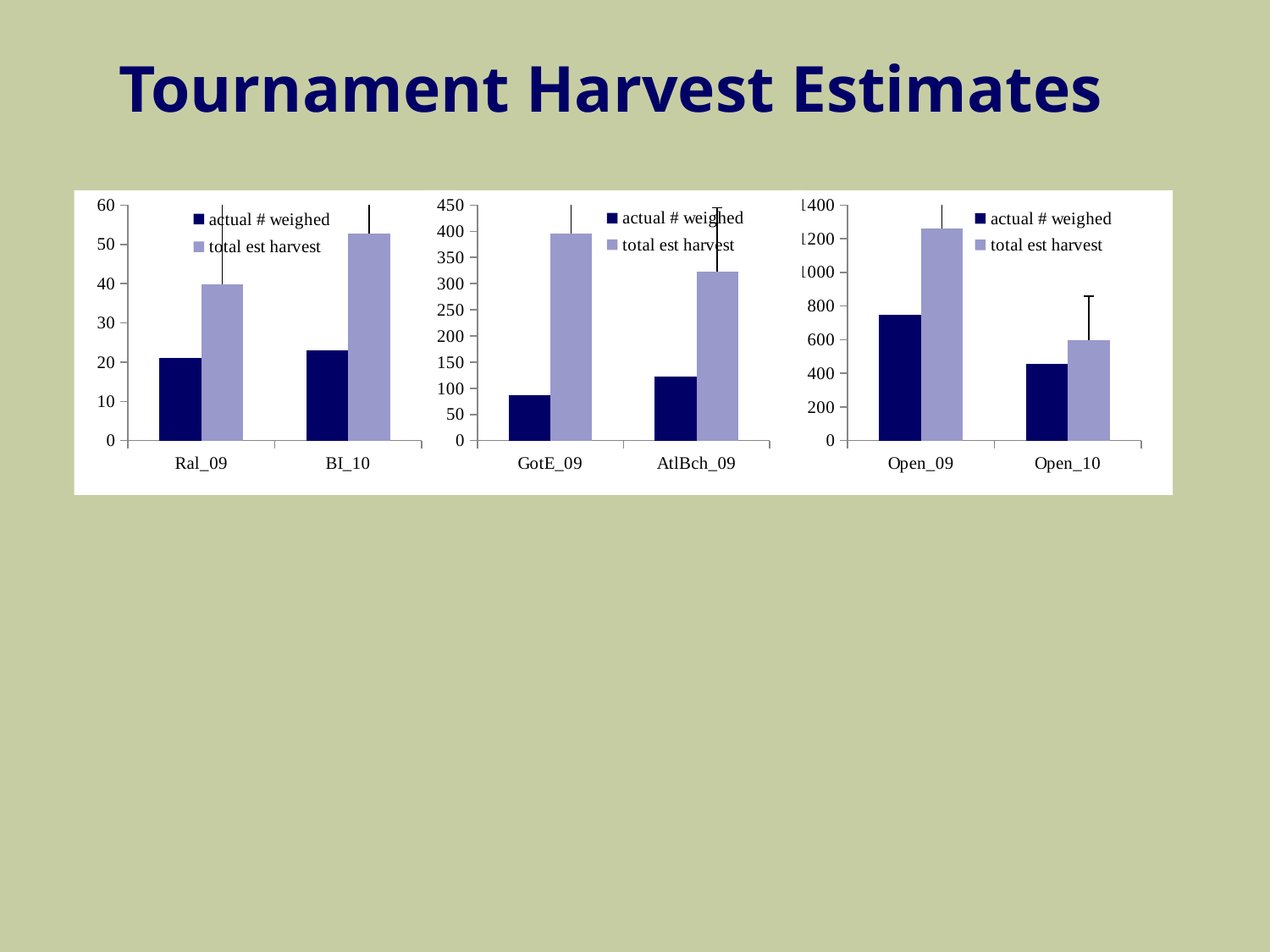
In the right chart (Open_09 and Open_10), which category has the highest total est harvest? Open_09 In the right chart, is the actual # weighed value for Open_10 greater or less than 600? less In the middle chart, is the actual # weighed value for AtlBch_09 greater or less than 100? greater In the right chart, is the total est harvest value for Open_09 greater or less than 1000? greater What kind of chart is the left chart (Ral_09 and BI_10)? bar chart In the middle chart, which category has the higher total est harvest, GotE_09 or AtlBch_09? GotE_09 How many categories are shown on the x axis of the middle chart (GotE_09 and AtlBch_09)? 2 In the middle chart, which category has the higher actual # weighed, GotE_09 or AtlBch_09? AtlBch_09 What are the two legend entries shown in the right chart? actual # weighed and total est harvest How many series does the legend of the left chart list? 2